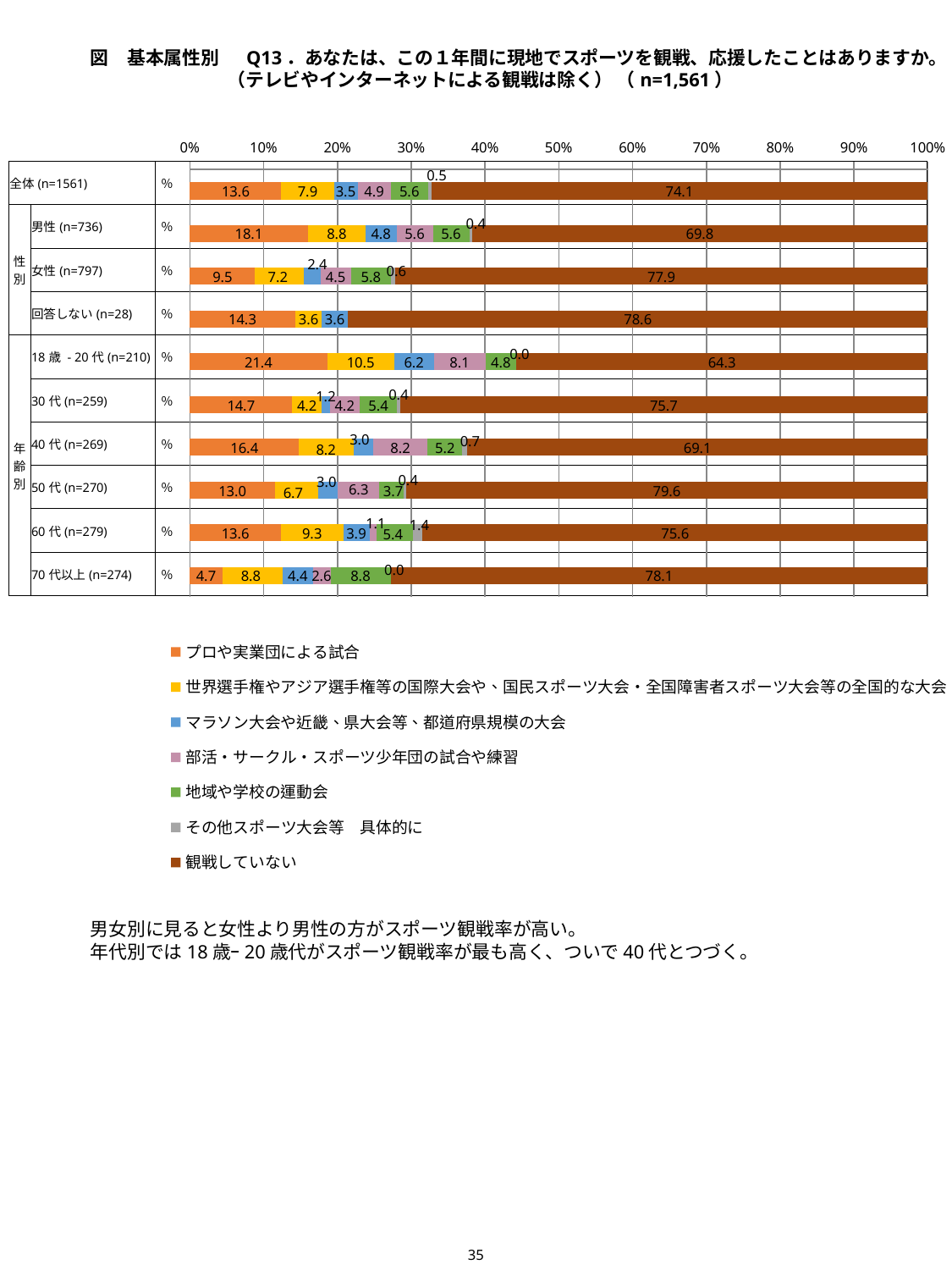
Which has the larger value for プロや実業団による試合, 男性 (n=736) or 女性 (n=797)? 男性 (n=736) What is the value for 観戦していない in the 18歳-20代 (n=210) row? 64.3 Which row has the highest value for 観戦していない? 50代 (n=270) What is the value for 観戦していない in the 全体 (n=1561) row? 74.1 Which row has the lowest value for 観戦していない? 18歳-20代 (n=210) What is the value for 世界選手権やアジア選手権等の国際大会や、国民スポーツ大会・全国障害者スポーツ大会等の全国的な大会 in the 60代 (n=279) row? 9.3 What kind of chart is shown on the slide? Stacked bar chart How many rows (categories) are plotted in the chart? 10 What is the difference between the 観戦していない values for 女性 (n=797) and 男性 (n=736)? 8.1 What is the value for プロや実業団による試合 in the 男性 (n=736) row? 18.1 Which row has the highest value for プロや実業団による試合? 18歳-20代 (n=210) How many series does the legend list? 7